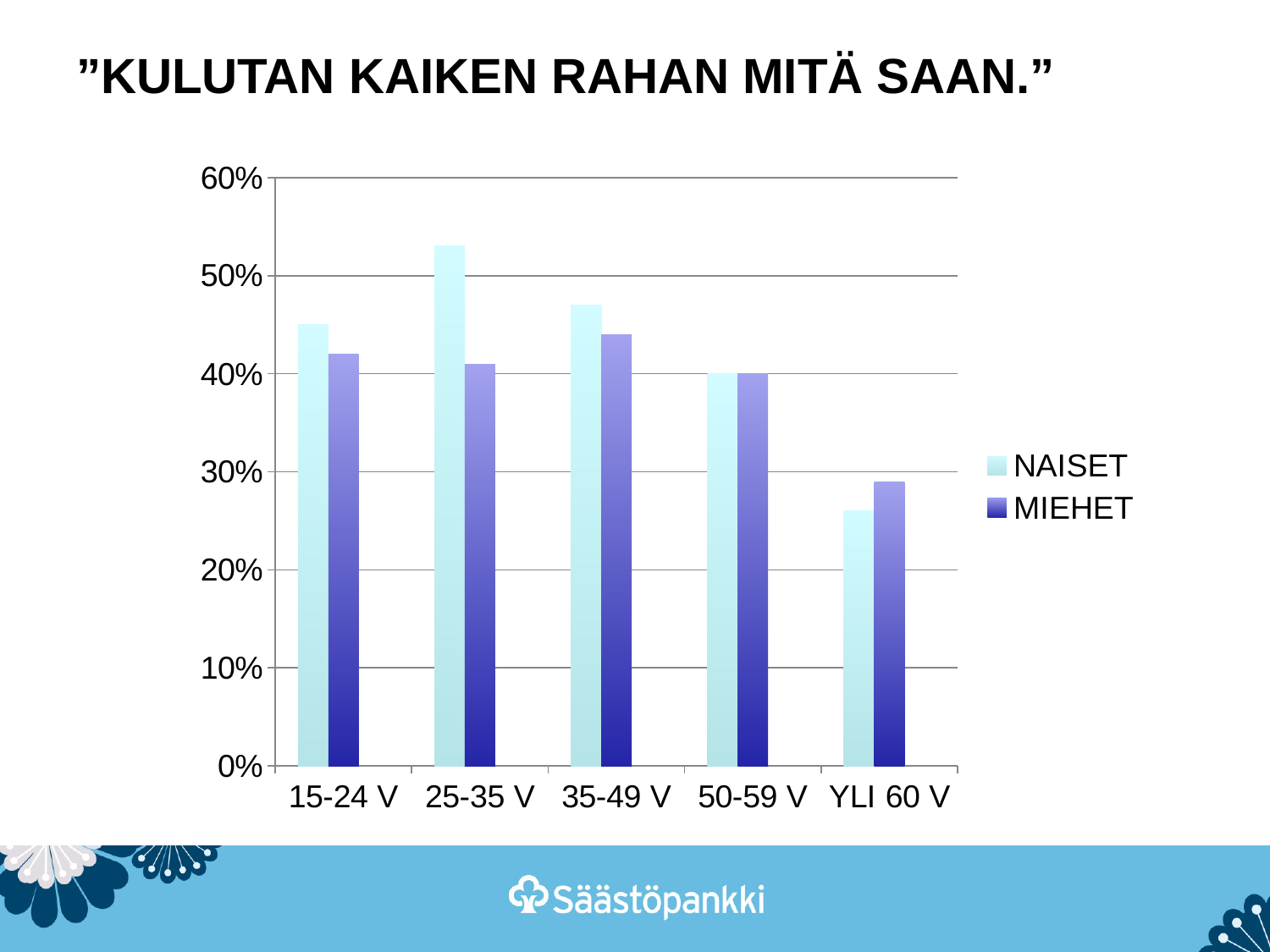
Which age group has the lowest MIEHET value? YLI 60 V What kind of chart is shown on the slide? bar chart For the YLI 60 V group, which is larger, NAISET or MIEHET? MIEHET For the 25-35 V group, which is larger, NAISET or MIEHET? NAISET Which age group has the lowest NAISET value? YLI 60 V How many series does the legend list? 2 Is the NAISET value for 15-24 V greater or less than 40%? greater How many age groups are shown on the x axis? 5 Do the NAISET values rise or fall from 25-35 V to YLI 60 V? fall Is the NAISET value for 25-35 V greater or less than 50%? greater Which age group has the highest NAISET value? 25-35 V